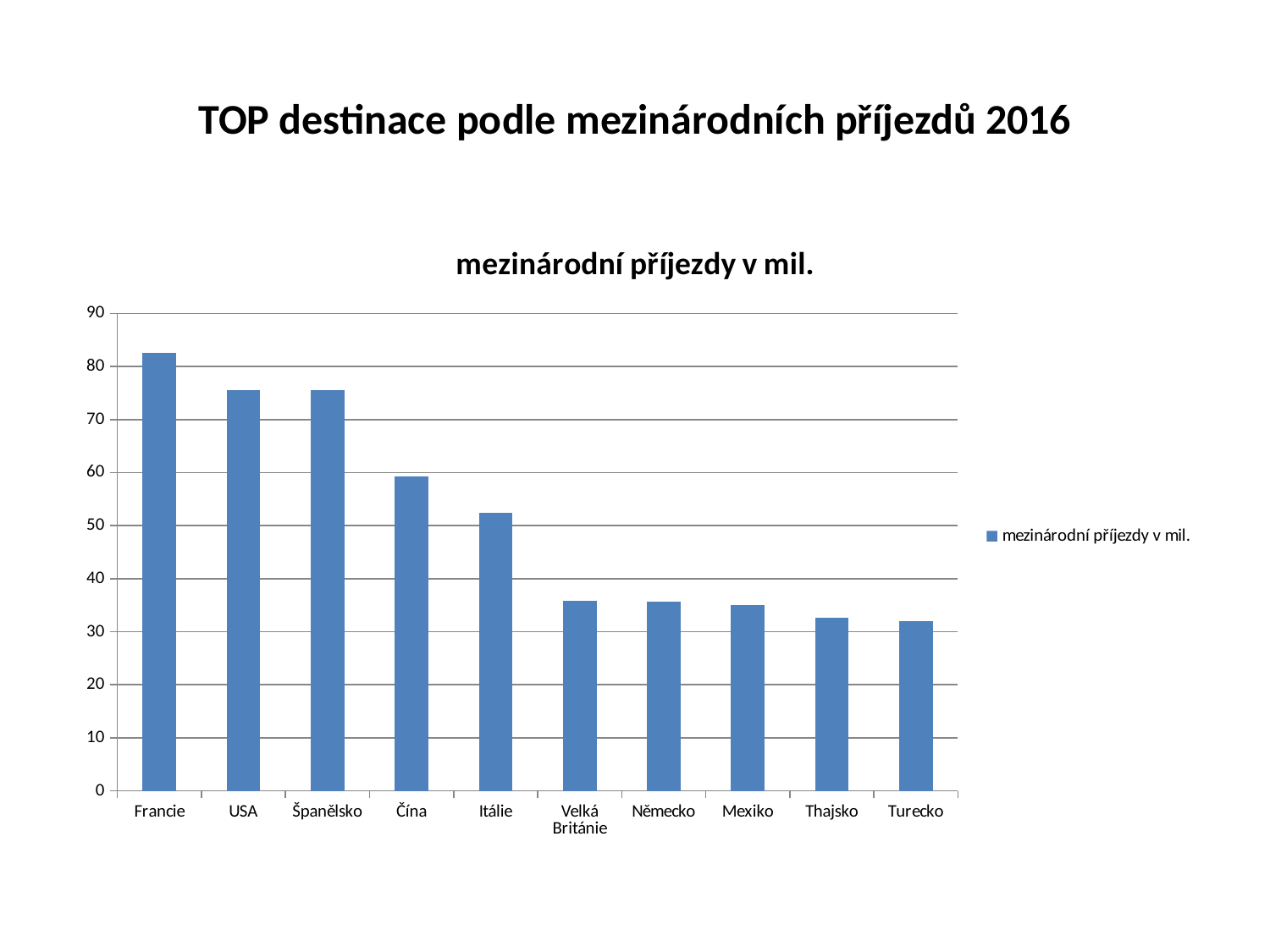
Is the value for Francie greater or less than 80? greater Is the value for Turecko greater or less than 30? greater What kind of chart is shown on the slide? bar chart Is the value for Itálie greater or less than 50? greater How many series does the legend list? 1 Which has a larger value, Čína or Itálie? Čína What is the title of the chart? mezinárodní příjezdy v mil. Do the values rise or fall from left to right along the x axis? fall Which destination has the highest value? Francie How many destinations (categories) are shown on the x axis? 10